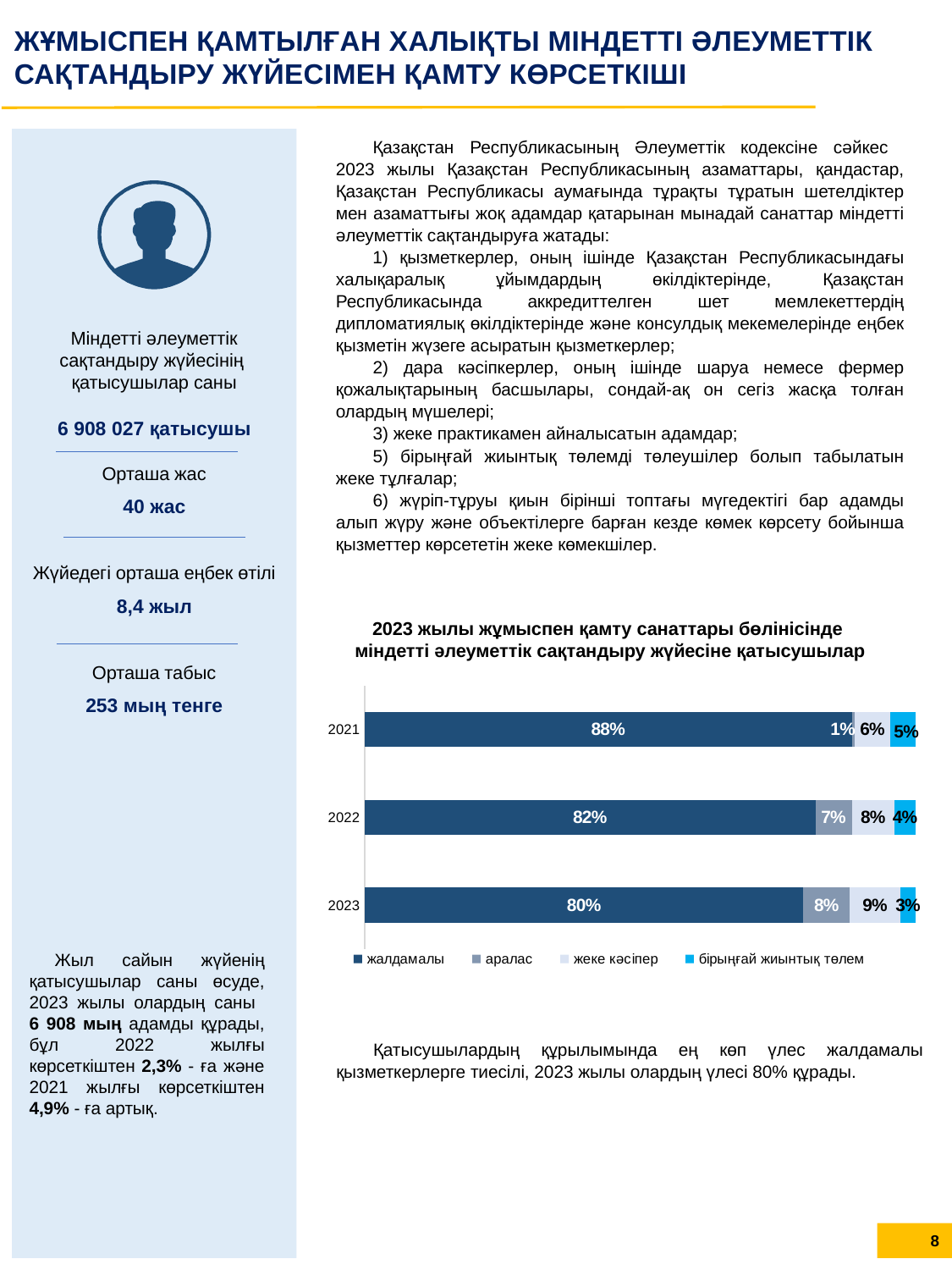
By how many percentage points did the share of жалдамалы participants fall from 2021 to 2023? 8% In which year was the share of аралас participants lowest? 2021 What share of participants were жеке кәсіпер in 2023? 9% Does the share of жалдамалы participants rise or fall from 2021 to 2023? Fall In which year was the share of жалдамалы participants highest? 2021 How many series does the legend list? 4 Which is larger in 2022: the share of жеке кәсіпер or the share of бірыңғай жиынтық төлем? жеке кәсіпер What share of participants were аралас in 2022? 7% What share of participants were жалдамалы in 2023? 80% How many years are shown on the chart? 3 What share of participants were бірыңғай жиынтық төлем in 2021? 5% What kind of chart is shown on the slide? Stacked bar chart